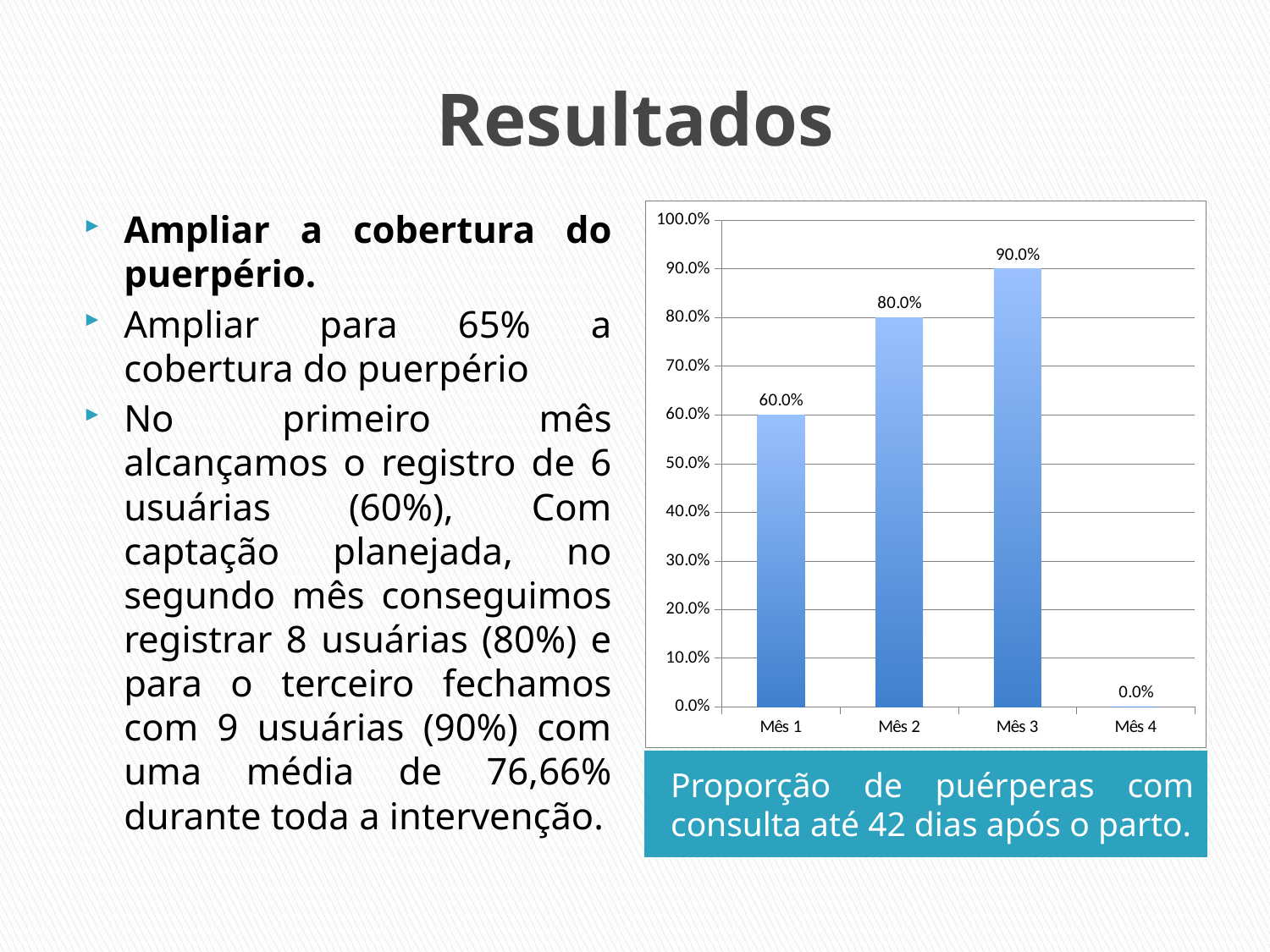
What kind of chart is shown? Bar chart Which month has the lowest value? Mês 4 How many months are shown on the x axis? 4 What is the difference between the values for Mês 3 and Mês 1? 30.0% Which is larger, the value for Mês 2 or the value for Mês 1? Mês 2 Which month has the highest value? Mês 3 What is the value for Mês 4? 0.0% What is the value for Mês 1? 60.0% What is the value for Mês 2? 80.0% Do the values rise or fall from Mês 1 to Mês 3? Rise What is the caption shown below the chart? Proporção de puérperas com consulta até 42 dias após o parto. What is the value for Mês 3? 90.0%